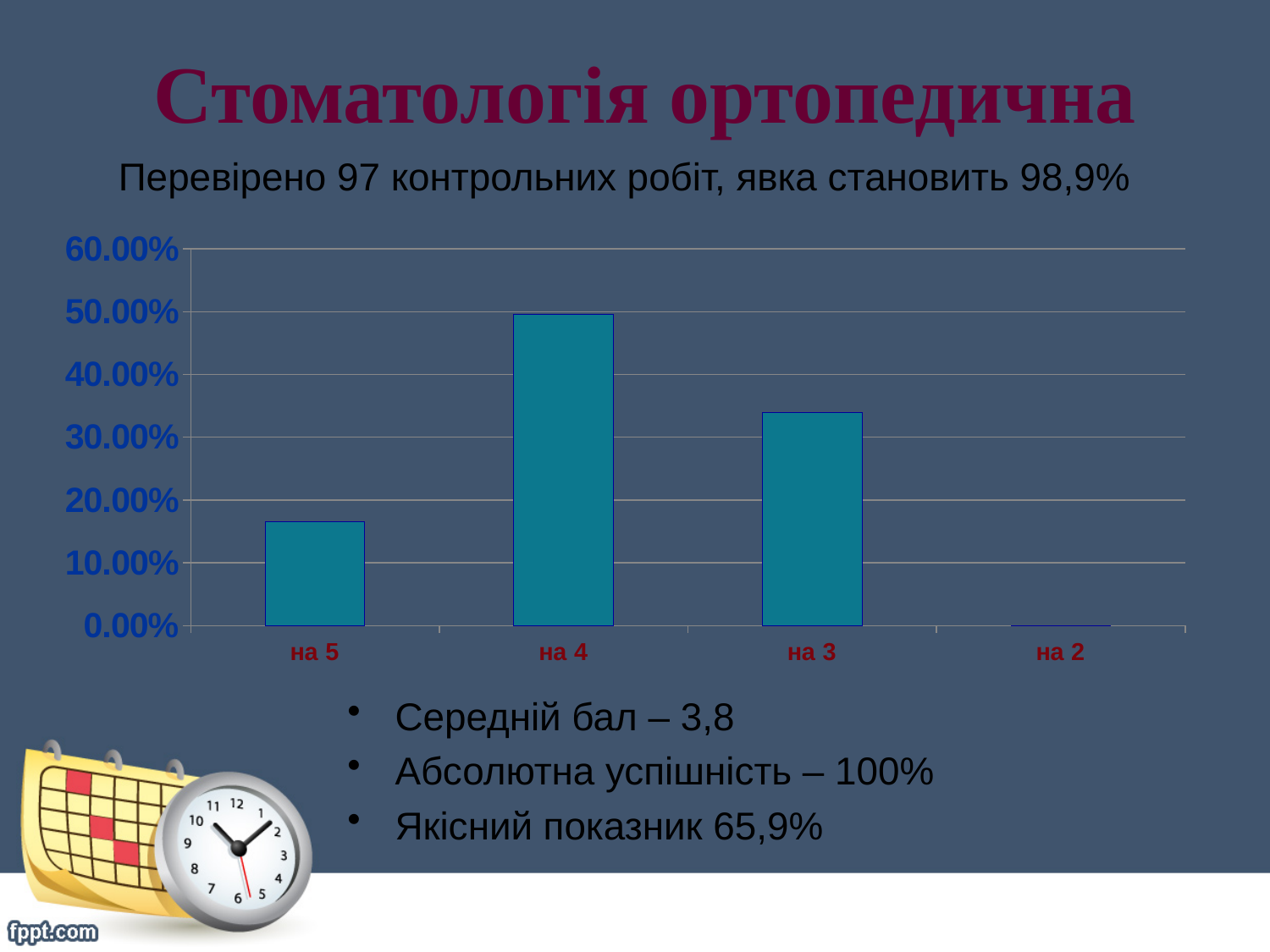
Is the value for на 3 greater or less than 30.00%? greater Which category has the highest bar in the chart? на 4 Which is larger, the value for на 4 or the value for на 3? на 4 Is the value for на 4 greater or less than 40.00%? greater Which is larger, the value for на 5 or the value for на 3? на 3 Which category has the lowest bar in the chart? на 2 How many categories are shown on the x axis of the chart? 4 Is the value for на 5 greater or less than 10.00%? greater What is the highest tick value shown on the y axis of the chart? 60.00% What kind of chart is shown on the slide? bar chart